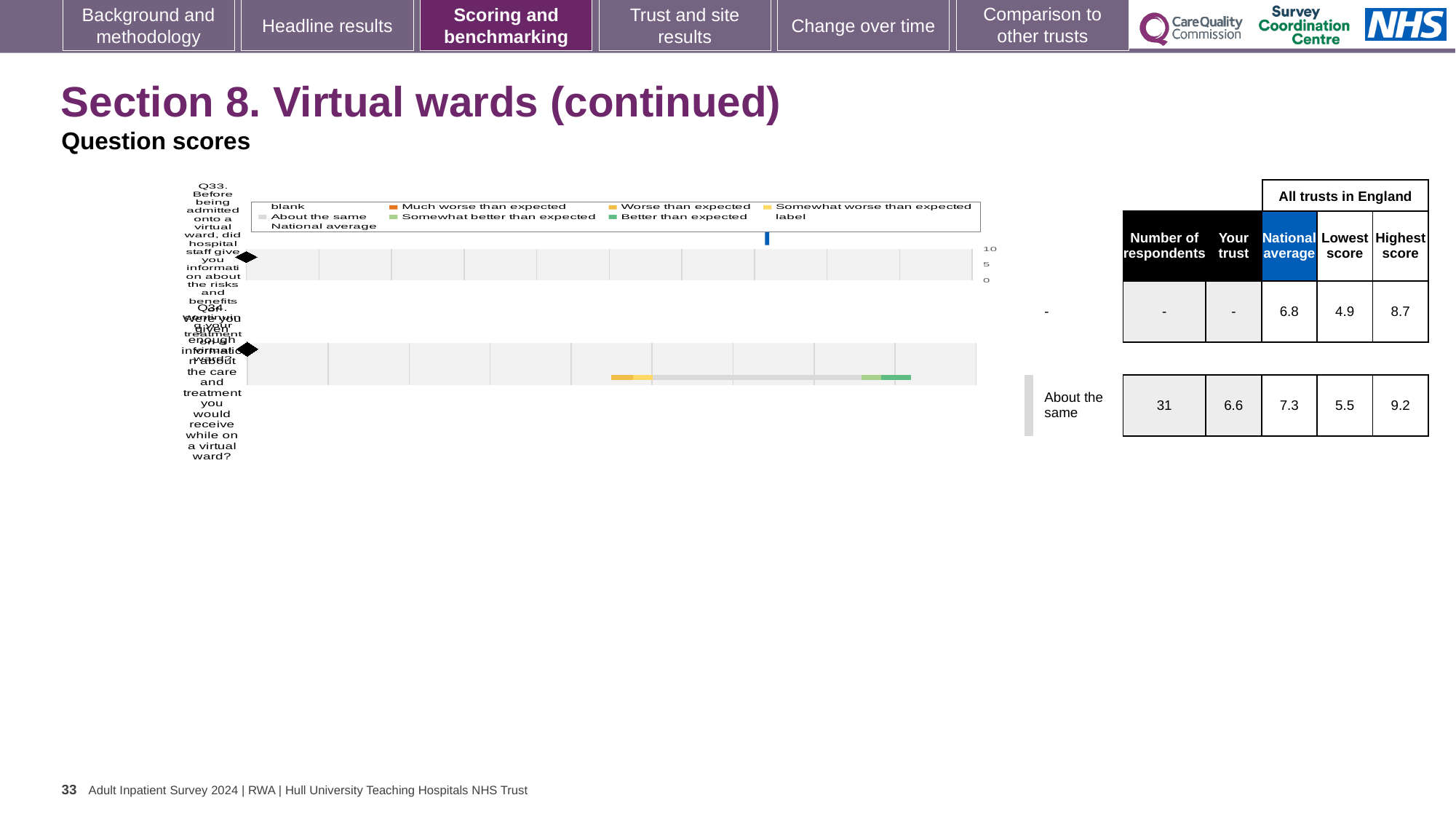
What benchmark category is shown for Q34? About the same Which question has the higher national average, Q33 or Q34? Q34 For Q34, which is larger: the 'Your trust' score or the national average? National average What is the lowest score among all trusts in England for Q33? 4.9 What is the 'Your trust' score for Q34? 6.6 How many respondents are recorded for Q34? 31 What is the difference between the highest and lowest scores for Q34? 3.7 What is the highest score among all trusts in England for Q34? 9.2 What is the national average score for Q34? 7.3 What kind of chart is used to show the question scores on this slide? Bar chart How many questions are plotted in the question scores chart? 2 What is the national average score for Q33? 6.8